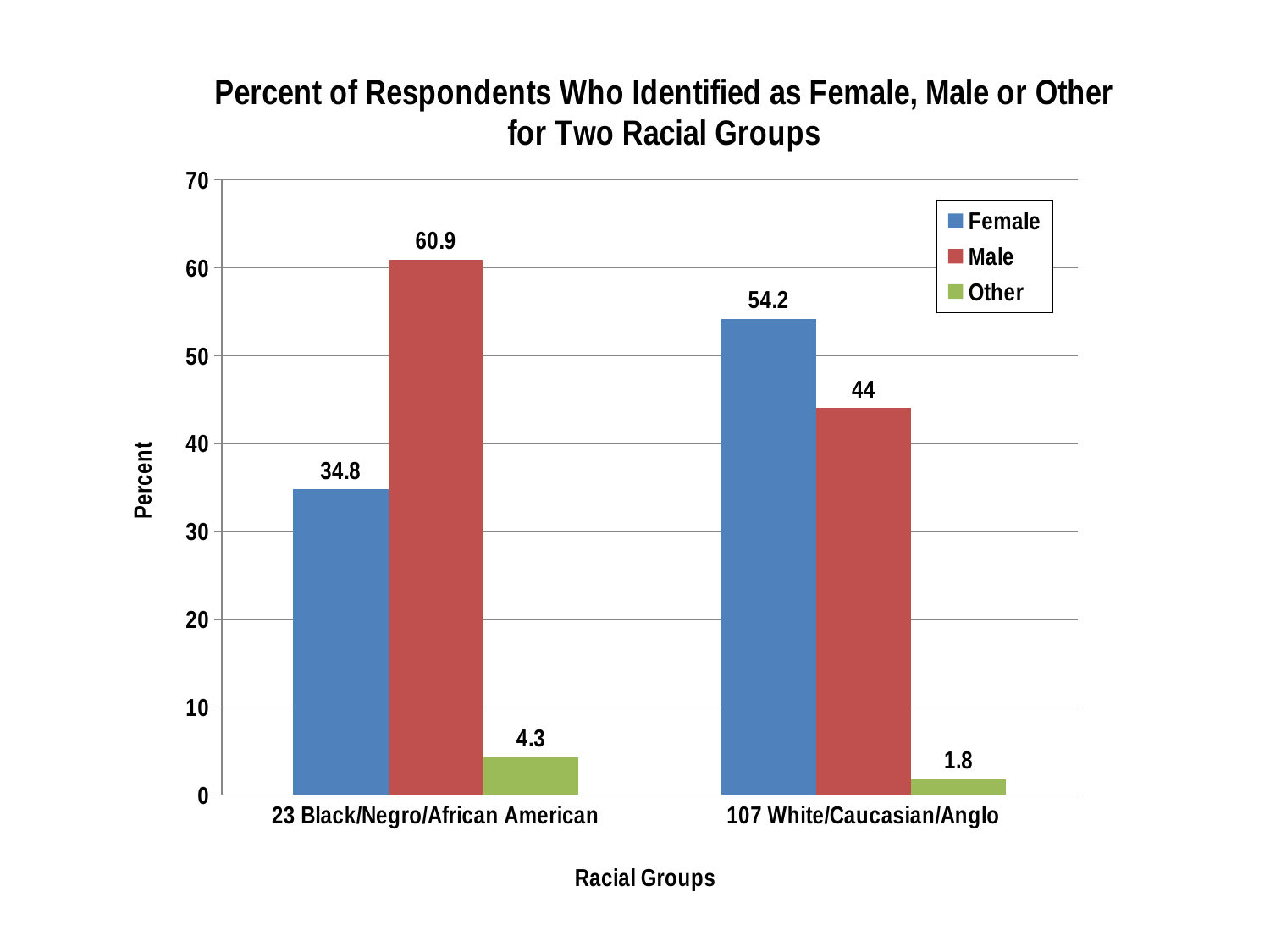
What is the difference between the Female values for the two racial groups? 19.4 What is the value for Other in the 23 Black/Negro/African American group? 4.3 What percent of the 107 White/Caucasian/Anglo respondents identified as Female? 54.2 Which is larger: the Other value for the 23 Black/Negro/African American group or for the 107 White/Caucasian/Anglo group? 23 Black/Negro/African American What kind of chart is shown on the slide? Bar chart Which series has the lowest value in the 107 White/Caucasian/Anglo group? Other How many racial groups are shown on the x axis? 2 How many series does the legend list? 3 Which series has the highest value in the 23 Black/Negro/African American group? Male What is the value for Male in the 107 White/Caucasian/Anglo group? 44 What percent of the 23 Black/Negro/African American respondents identified as Male? 60.9 What is the difference between the Male and Female values for the 23 Black/Negro/African American group? 26.1